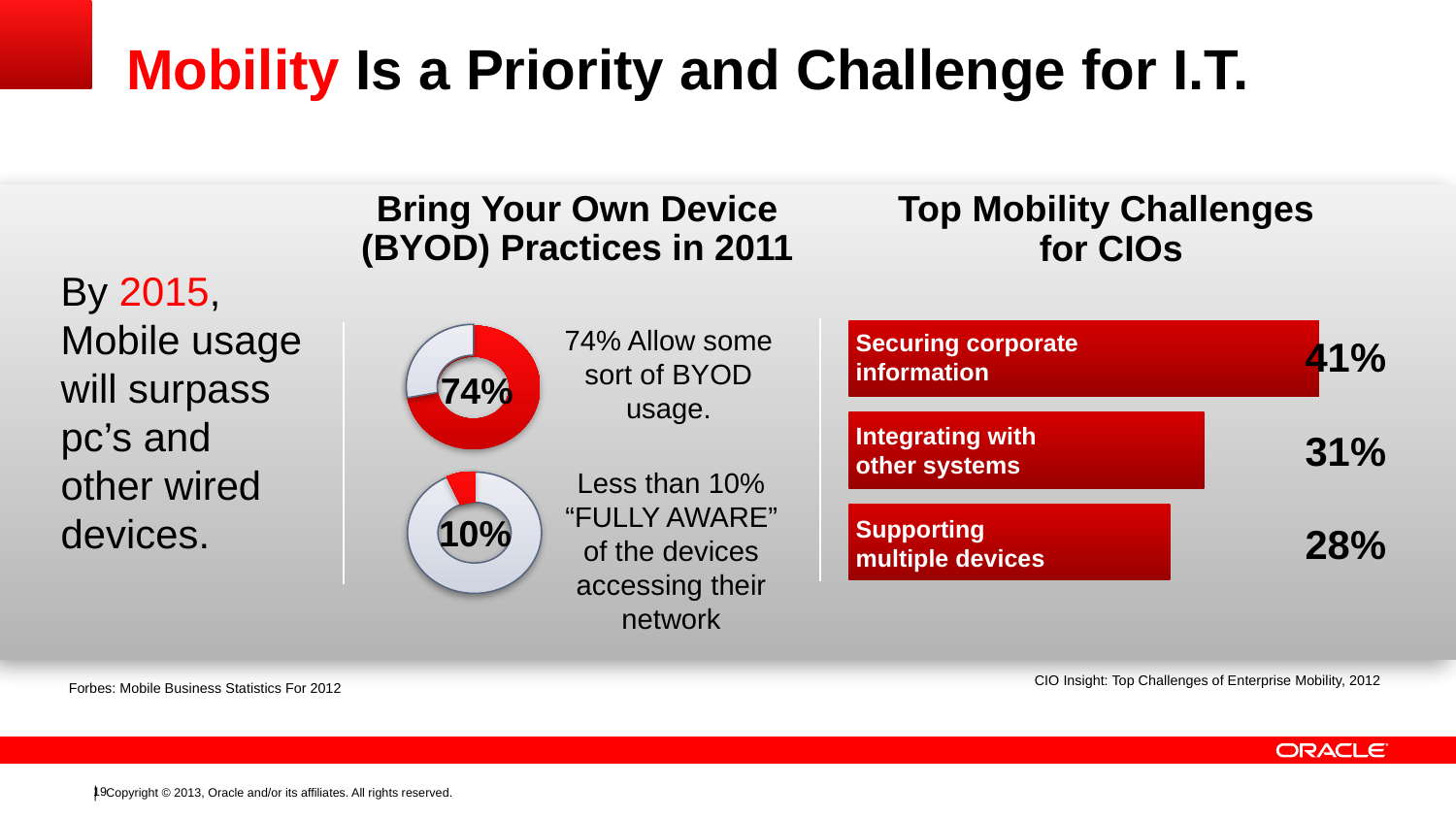
What kind of chart is the Top Mobility Challenges for CIOs chart? Bar chart In the Top Mobility Challenges for CIOs chart, what is the value for Integrating with other systems? 31% In the Top Mobility Challenges for CIOs chart, which challenge has the lowest value? Supporting multiple devices What is the title of the chart on the right side of the slide? Top Mobility Challenges for CIOs How many challenges are shown in the Top Mobility Challenges for CIOs chart? 3 In the Top Mobility Challenges for CIOs chart, what is the value for Supporting multiple devices? 28% In the BYOD Practices in 2011 section, what percentage is shown in the lower donut chart? 10% In the BYOD Practices in 2011 section, what percentage is shown in the upper donut chart? 74% In the Top Mobility Challenges for CIOs chart, which is larger: Integrating with other systems or Supporting multiple devices? Integrating with other systems In the Top Mobility Challenges for CIOs chart, what is the value for Securing corporate information? 41% In the Top Mobility Challenges for CIOs chart, which challenge has the highest value? Securing corporate information In the Top Mobility Challenges for CIOs chart, what is the difference between Securing corporate information and Supporting multiple devices? 13%